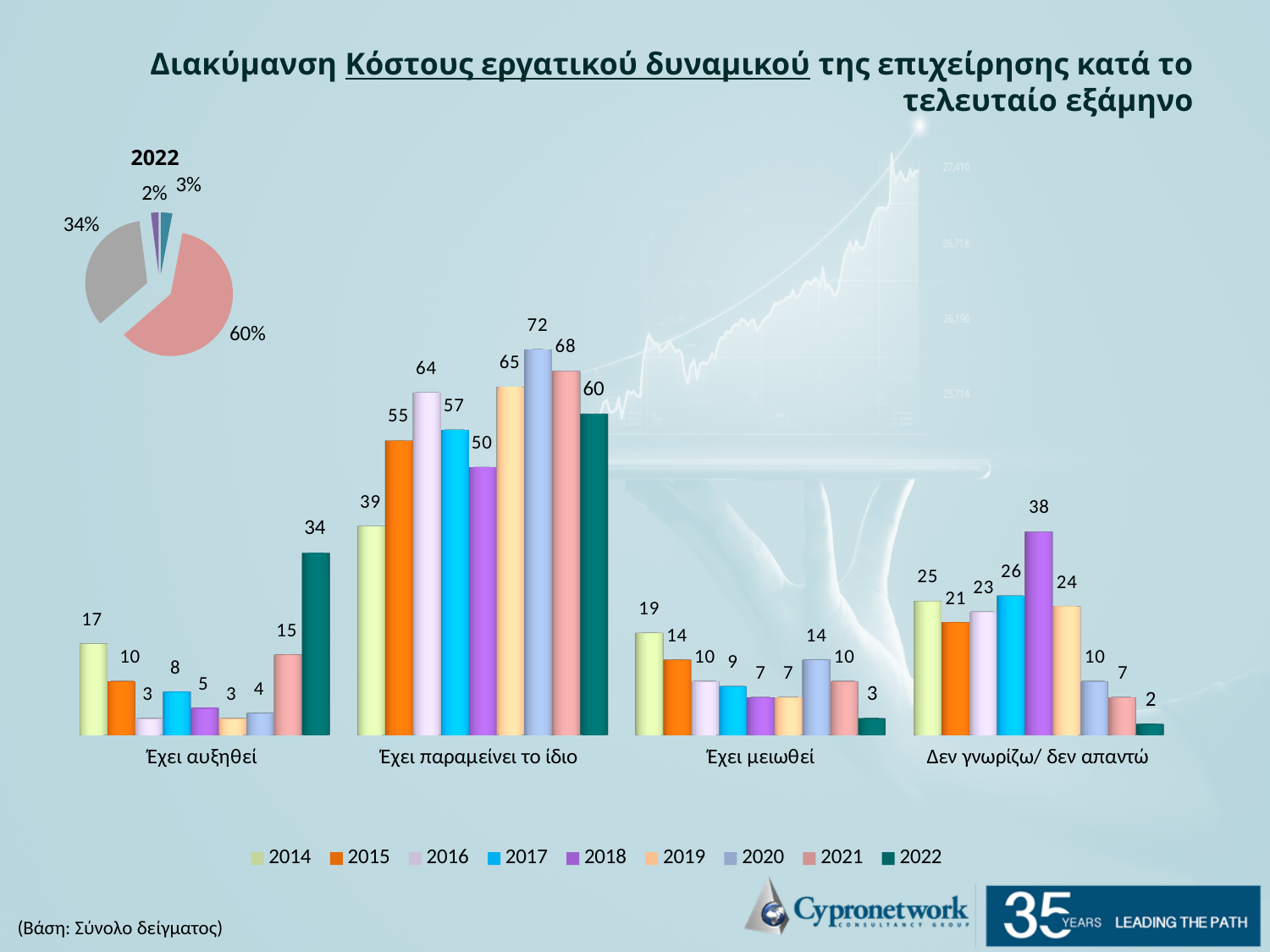
In the pie chart labelled 2022, what is the share of the grey slice? 34% In the bar chart, which year has the lowest value in the category 'Δεν γνωρίζω/ δεν απαντώ'? 2022 In the bar chart, what is the difference between the 2022 and 2021 values in the category 'Έχει αυξηθεί'? 19 In the bar chart, which is larger in the category 'Έχει μειωθεί': the value for 2014 or the value for 2022? 2014 In the bar chart, what is the value for 2022 in the category 'Έχει αυξηθεί'? 34 How many series does the legend of the bar chart list? 9 In the bar chart, which year has the highest value in the category 'Έχει παραμείνει το ίδιο'? 2020 In the pie chart labelled 2022, what is the share of the largest slice? 60% In the bar chart, what is the value for 2018 in the category 'Δεν γνωρίζω/ δεν απαντώ'? 38 What kind of chart is the large chart on the slide? Bar chart How many categories are shown on the x axis of the bar chart? 4 In the bar chart, what is the value for 2020 in the category 'Έχει παραμείνει το ίδιο'? 72